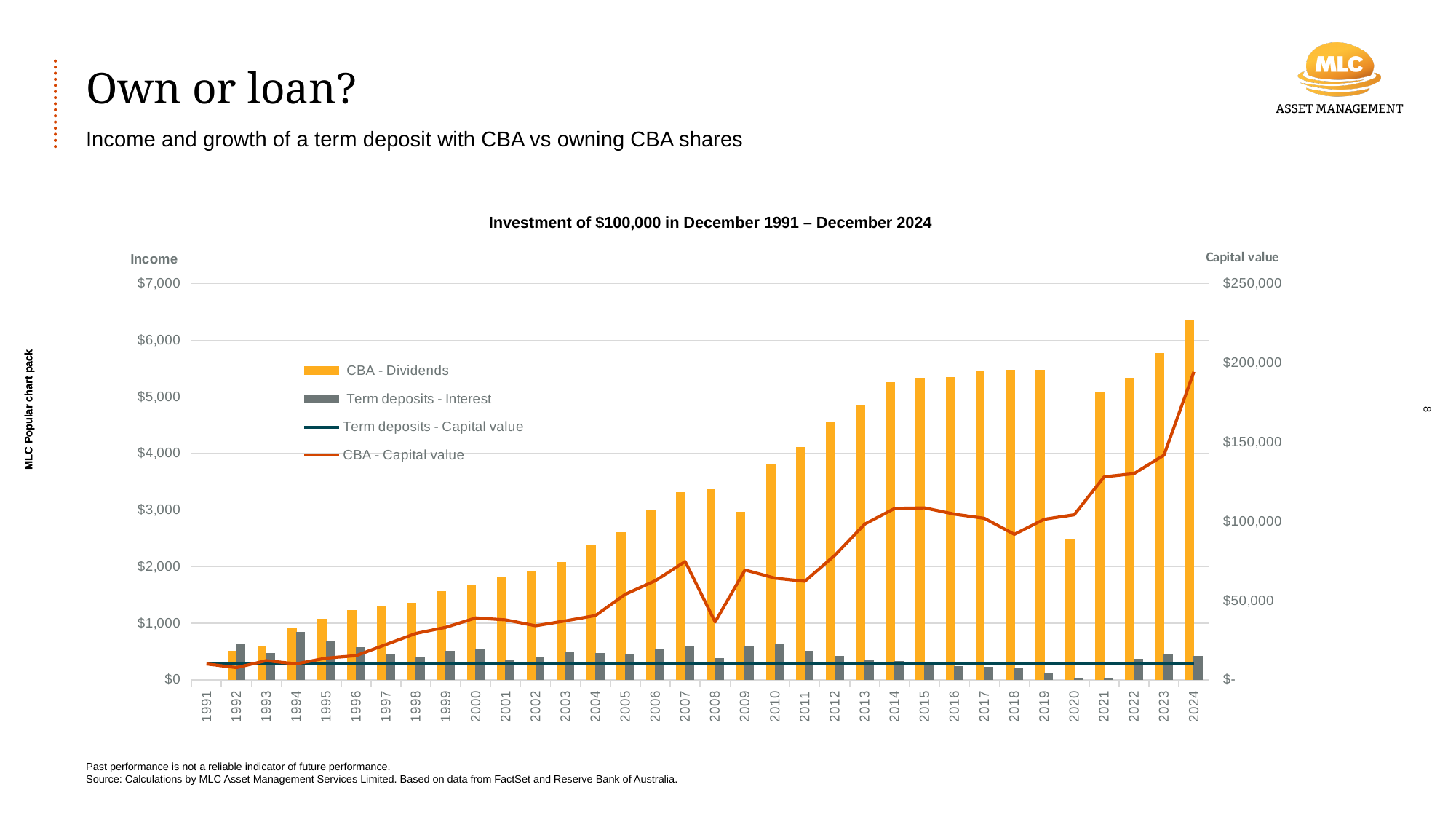
What is the title of the chart? Investment of $100,000 in December 1991 – December 2024 Is the CBA - Capital value in 2024 greater or less than $150,000? greater In which year are CBA - Dividends highest? 2024 In which year is Term deposits - Interest highest? 1994 How many years are shown along the x axis? 34 Which is larger, CBA - Dividends in 2019 or in 2020? 2019 Is the CBA - Capital value in 2008 greater or less than $50,000? less What kind of chart is shown on the slide? A combination bar and line chart Do CBA - Dividends generally rise or fall from 1991 to 2024? rise Is the value of CBA - Dividends in 2020 greater or less than $3,000? less How many series does the legend list? 4